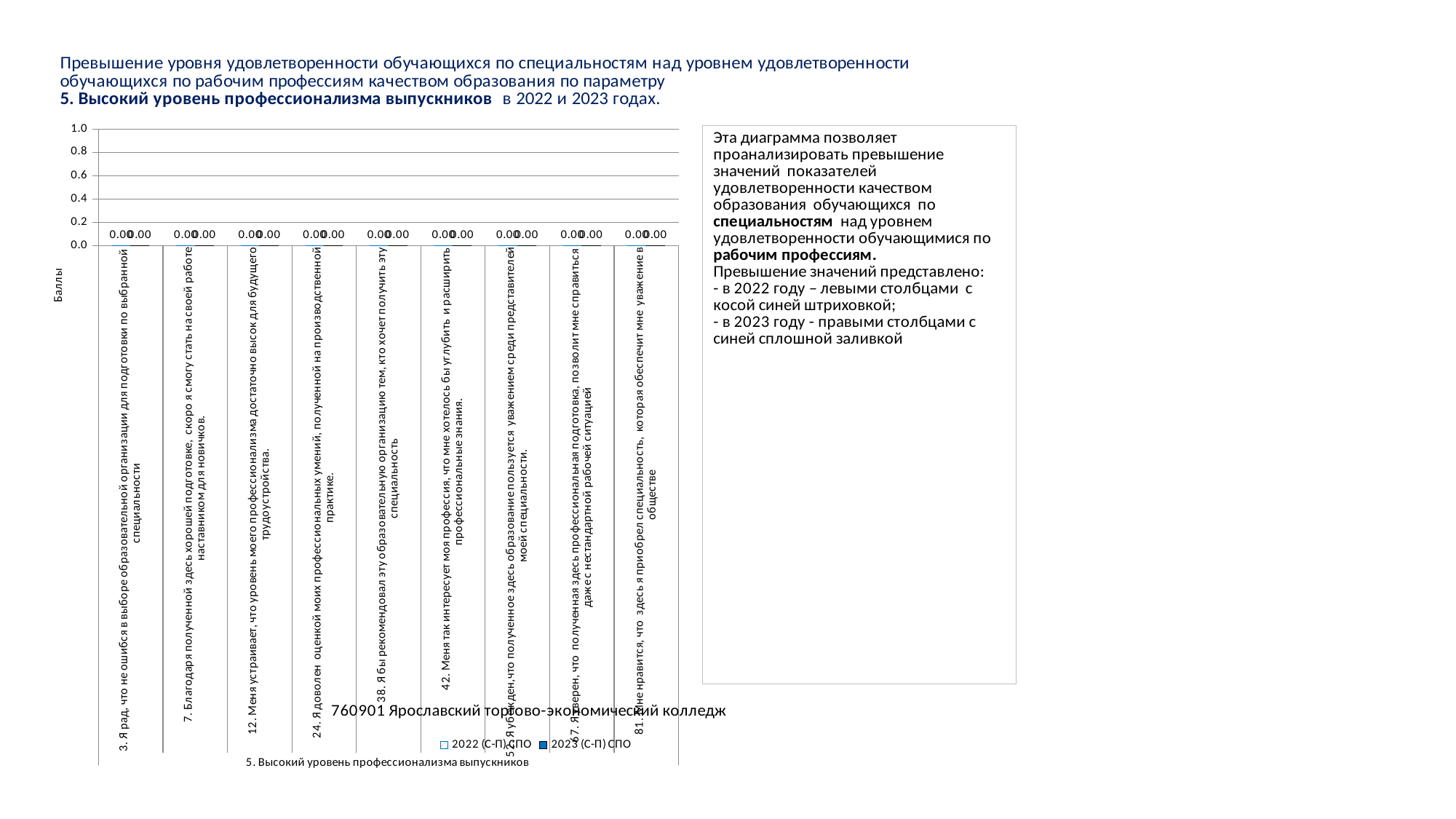
Is the value of the 2023 (С-П) СПО series for statement 12 greater or less than 0.2? less What is the label of the vertical axis of the chart? Баллы What is the value of the 2023 (С-П) СПО series for statement 81 ("Мне нравится, что здесь я приобрел специальность...")? 0.00 What is the value of the 2022 (С-П) СПО series for statement 3 ("Я рад, что не ошибся в выборе образовательной организации...")? 0.00 What kind of chart is shown on the slide? bar chart How many series does the chart legend list? 2 How many categories (statements) are plotted along the x axis of the chart? 9 What are the two series names listed in the chart legend? 2022 (С-П) СПО and 2023 (С-П) СПО What is the difference between the 2022 (С-П) СПО and 2023 (С-П) СПО values for statement 24 ("Я доволен оценкой моих профессиональных умений...")? 0.00 Do the values of the 2022 (С-П) СПО series rise, fall, or stay the same across the statements on the x axis? stay the same What is the highest tick value shown on the vertical axis of the chart? 1.0 What is the value of the 2022 (С-П) СПО series for statement 42 ("Меня так интересует моя профессия...")? 0.00